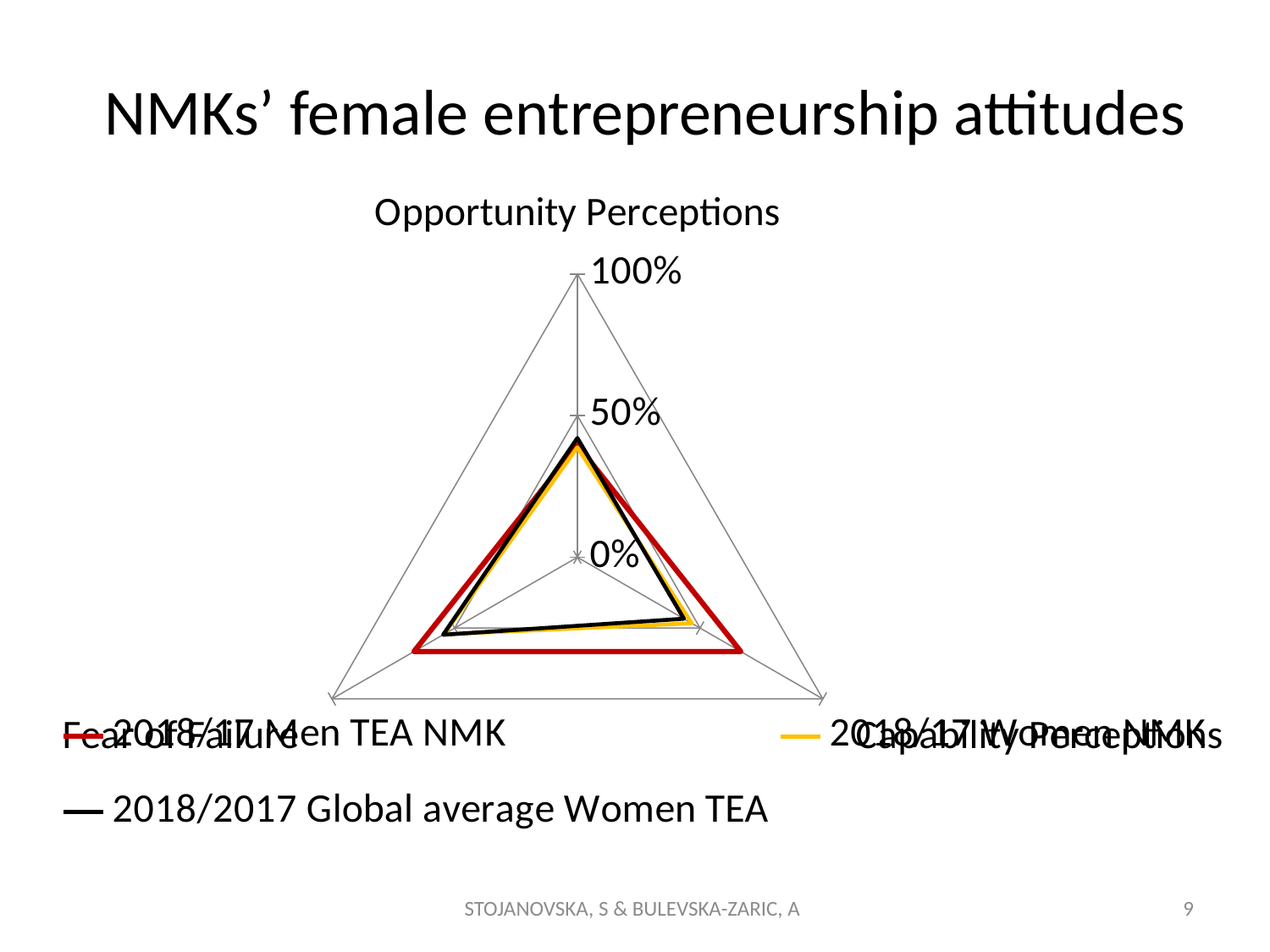
Is the value for 2018/17 Women NMK on the Opportunity Perceptions axis greater or less than 50%? less Is the value for 2018/17 Men TEA NMK on the Opportunity Perceptions axis greater or less than 50%? less On the Fear of Failure axis, which is larger: 2018/17 Men TEA NMK or 2018/17 Women NMK? 2018/17 Men TEA NMK What colour is the line for the 2018/17 Men TEA NMK series? Red Is the value for 2018/2017 Global average Women TEA on the Opportunity Perceptions axis greater or less than 50%? less What is the title of the slide containing the chart? NMKs' female entrepreneurship attitudes How many series does the legend list? 3 On the Capability Perceptions axis, which is larger: 2018/17 Men TEA NMK or 2018/17 Women NMK? 2018/17 Men TEA NMK How many categories (axes) does the radar chart have? 3 What kind of chart is shown on the slide? Radar chart